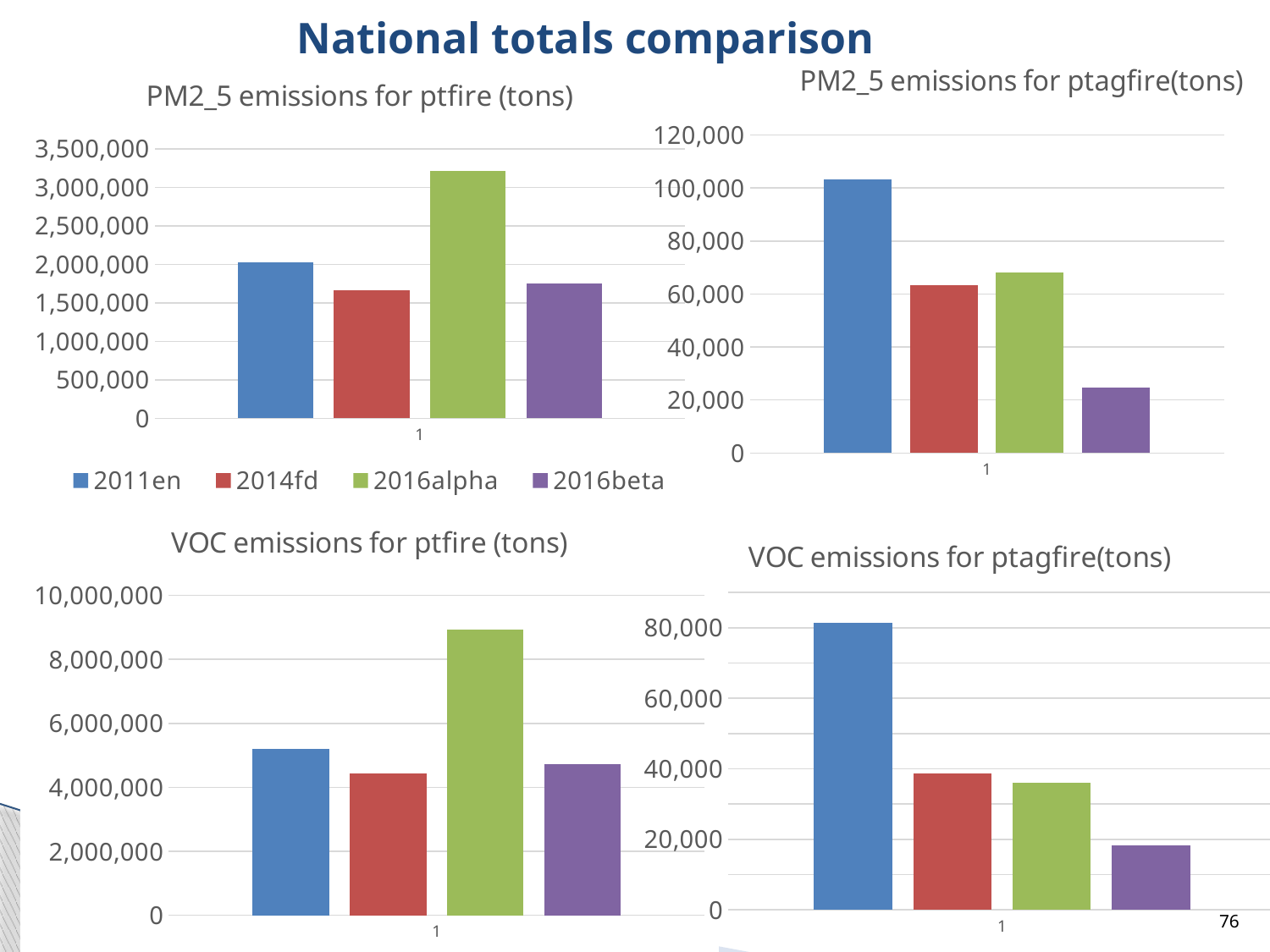
How many series does the legend on the slide list? 4 In the "PM2_5 emissions for ptfire (tons)" chart, which series has the highest value? 2016alpha In the "PM2_5 emissions for ptfire (tons)" chart, is the value for 2016alpha greater or less than 3,000,000? greater In the "PM2_5 emissions for ptagfire(tons)" chart, which series has the highest value? 2011en In the "VOC emissions for ptagfire(tons)" chart, which is larger, the value for 2011en or the value for 2014fd? 2011en What kind of chart is the "PM2_5 emissions for ptfire (tons)" chart? bar chart In the "VOC emissions for ptfire (tons)" chart, which series has the highest value? 2016alpha How many charts are shown on the slide? 4 In the "VOC emissions for ptfire (tons)" chart, is the value for 2016alpha greater or less than 8,000,000? greater